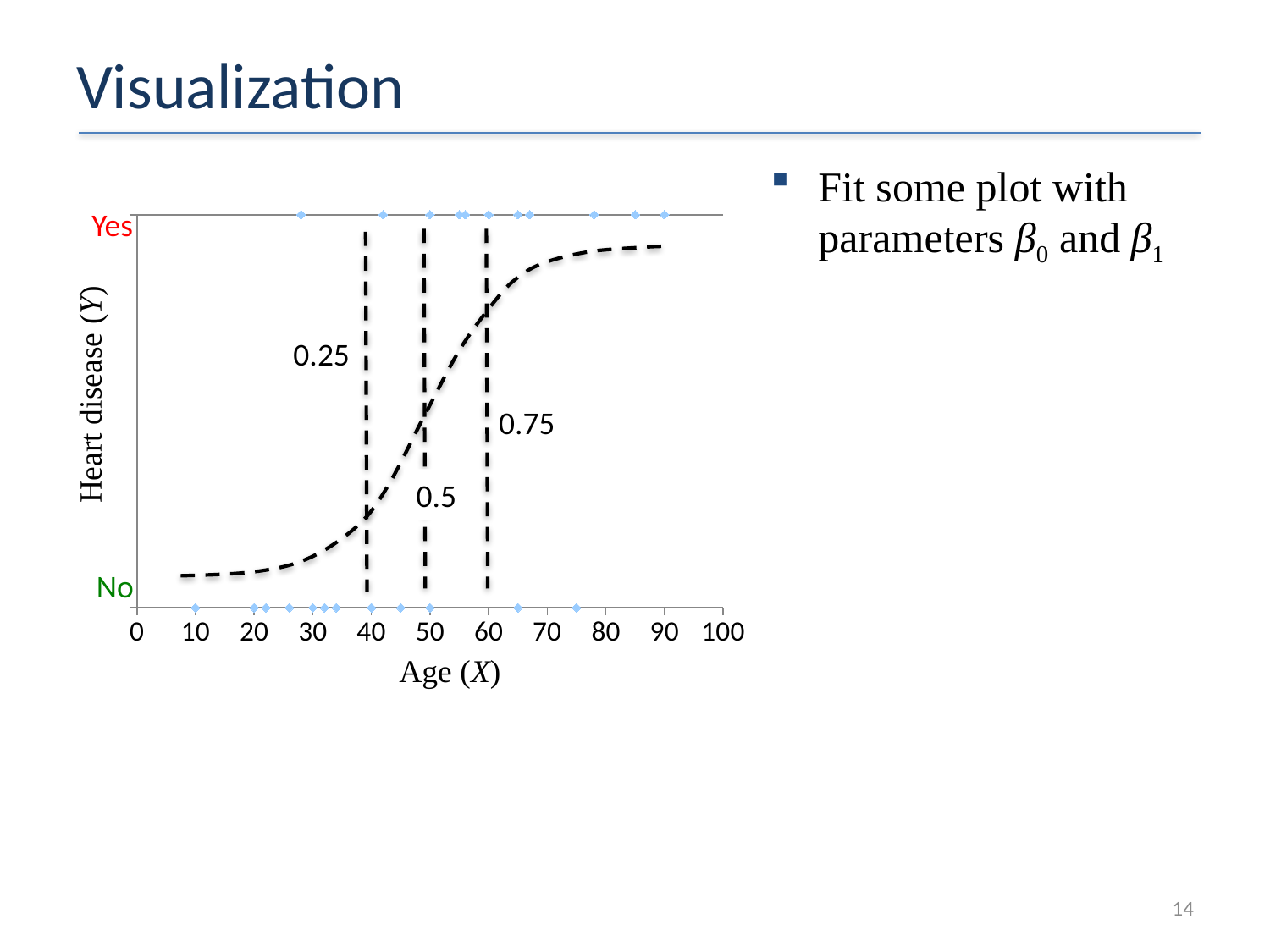
What value is labelled on the dashed vertical line at age 50? 0.5 Which of the labelled dashed lines has the largest value? 0.75 What value is labelled on the dashed vertical line at age 60? 0.75 Which of the labelled dashed lines has the smallest value? 0.25 What is the label of the y axis? Heart disease (Y) How many dashed vertical lines are drawn on the chart? 3 Is the fitted curve higher at age 60 or at age 40? Age 60 Does the fitted dashed curve rise or fall as age increases? Rises What kind of chart is shown on the slide? Scatter plot What is the label of the x axis? Age (X) What value is labelled on the dashed vertical line at age 40? 0.25 What is the highest tick value shown on the x axis? 100